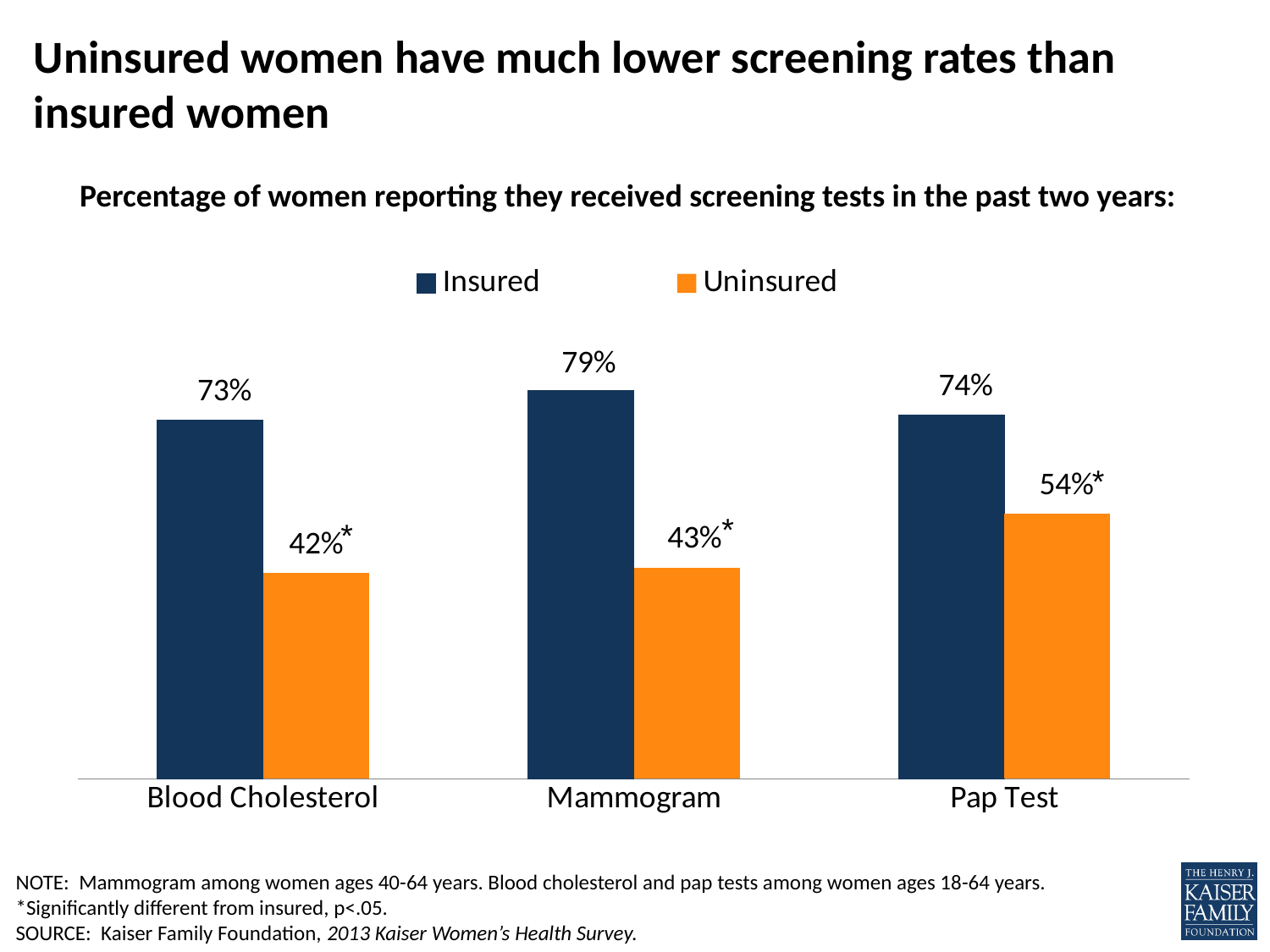
What kind of chart is shown on the slide? Bar chart Which screening test has the lowest rate among uninsured women? Blood Cholesterol How many screening test categories are shown on the x axis? 3 What is the value for uninsured women for Blood Cholesterol? 42% Which colour represents the Uninsured series in the legend? Orange What is the difference between the insured and uninsured rates for Pap Test? 20 percentage points What percentage of insured women reported receiving a mammogram? 79% Which screening test has the highest rate among insured women? Mammogram Which is larger: the uninsured rate for Pap Test or the uninsured rate for Mammogram? Pap Test What is the difference between the insured and uninsured rates for Mammogram? 36 percentage points How many series does the legend list? 2 What percentage of uninsured women reported receiving a pap test? 54%